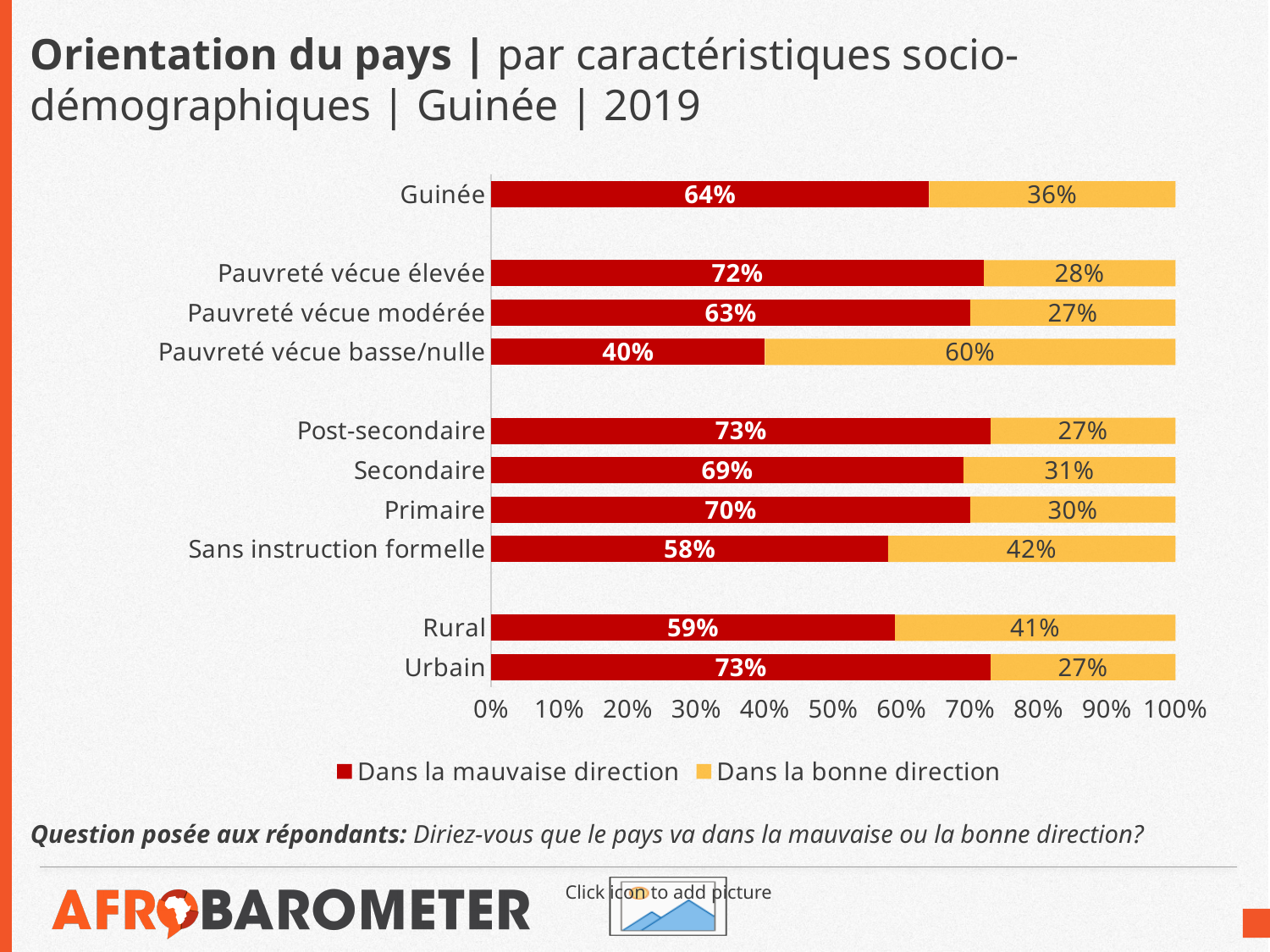
Which category has the highest 'Dans la bonne direction' value? Pauvreté vécue basse/nulle Which category has the lowest 'Dans la mauvaise direction' value? Pauvreté vécue basse/nulle Which has a larger 'Dans la mauvaise direction' value, Rural or Urbain? Urbain How many categories are plotted on the chart? 10 What is the difference in percentage points between the 'Dans la mauvaise direction' values for Urbain and Rural? 14 percentage points Is the 'Dans la mauvaise direction' value for Pauvreté vécue élevée greater or less than 70%? greater What is the 'Dans la mauvaise direction' value for Sans instruction formelle? 58% What is the value for 'Dans la bonne direction' for Pauvreté vécue basse/nulle? 60% What colour represents 'Dans la bonne direction' in the chart? Yellow/orange What type of chart is shown on the slide? Stacked bar chart How many series does the legend list? 2 What percentage of respondents in Guinée overall say the country is going in the wrong direction (Dans la mauvaise direction)? 64%